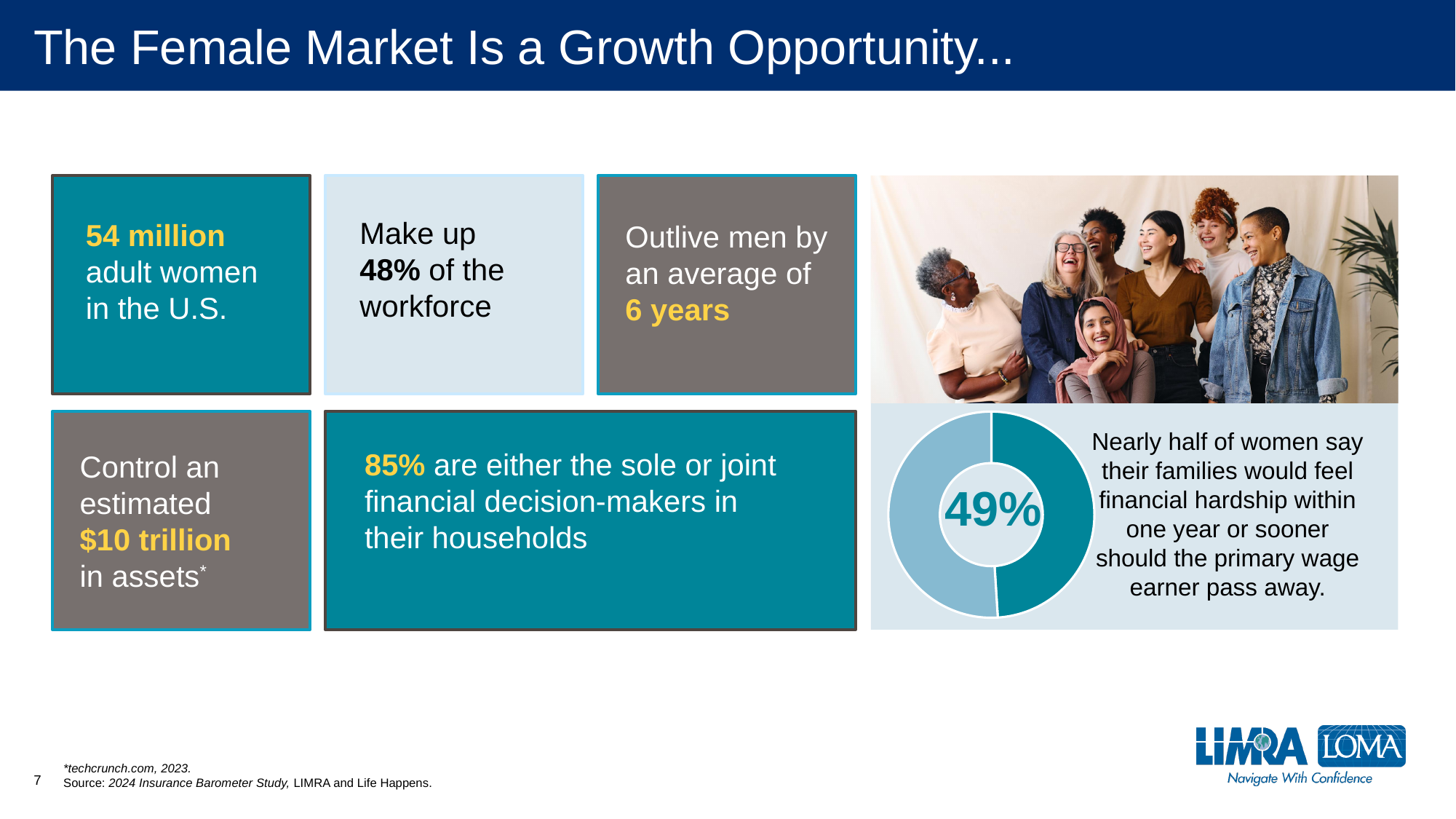
What value is printed in the center of the donut chart? 49% Is the value shown in the donut chart greater or less than 50%? less How many slices does the donut chart have? 2 What share of the donut chart does the highlighted dark teal slice represent? 49% What is the source cited for the donut chart data? 2024 Insurance Barometer Study, LIMRA and Life Happens What does the 49% in the donut chart represent? Women who say their families would feel financial hardship within one year or sooner should the primary wage earner pass away What kind of chart is shown on the slide? Donut (pie) chart